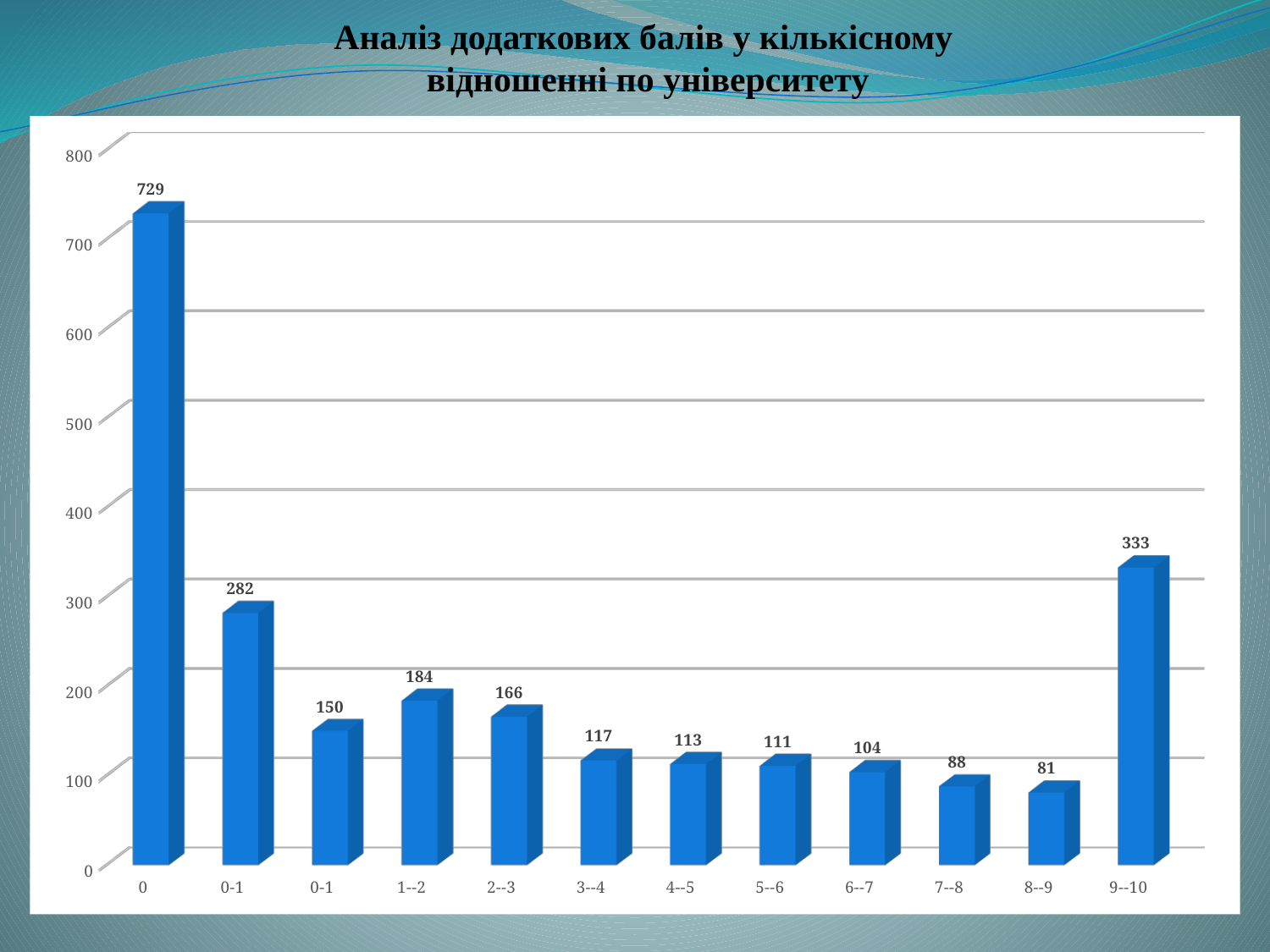
Which is larger, the value for 3--4 or the value for 6--7? 3--4 What is the value for the category 1--2? 184 What is the value for the category 5--6? 111 What is the value for the category 9--10? 333 Which category has the lowest value? 8--9 What is the title of the chart on the slide? Аналіз додаткових балів у кількісному відношенні по університету How many bars are shown in the chart? 12 What is the difference between the values for 9--10 and 2--3? 167 What kind of chart is shown on the slide? bar chart What is the value for the category 0? 729 Is the value for 7--8 greater or less than 100? less Which category has the highest value? 0